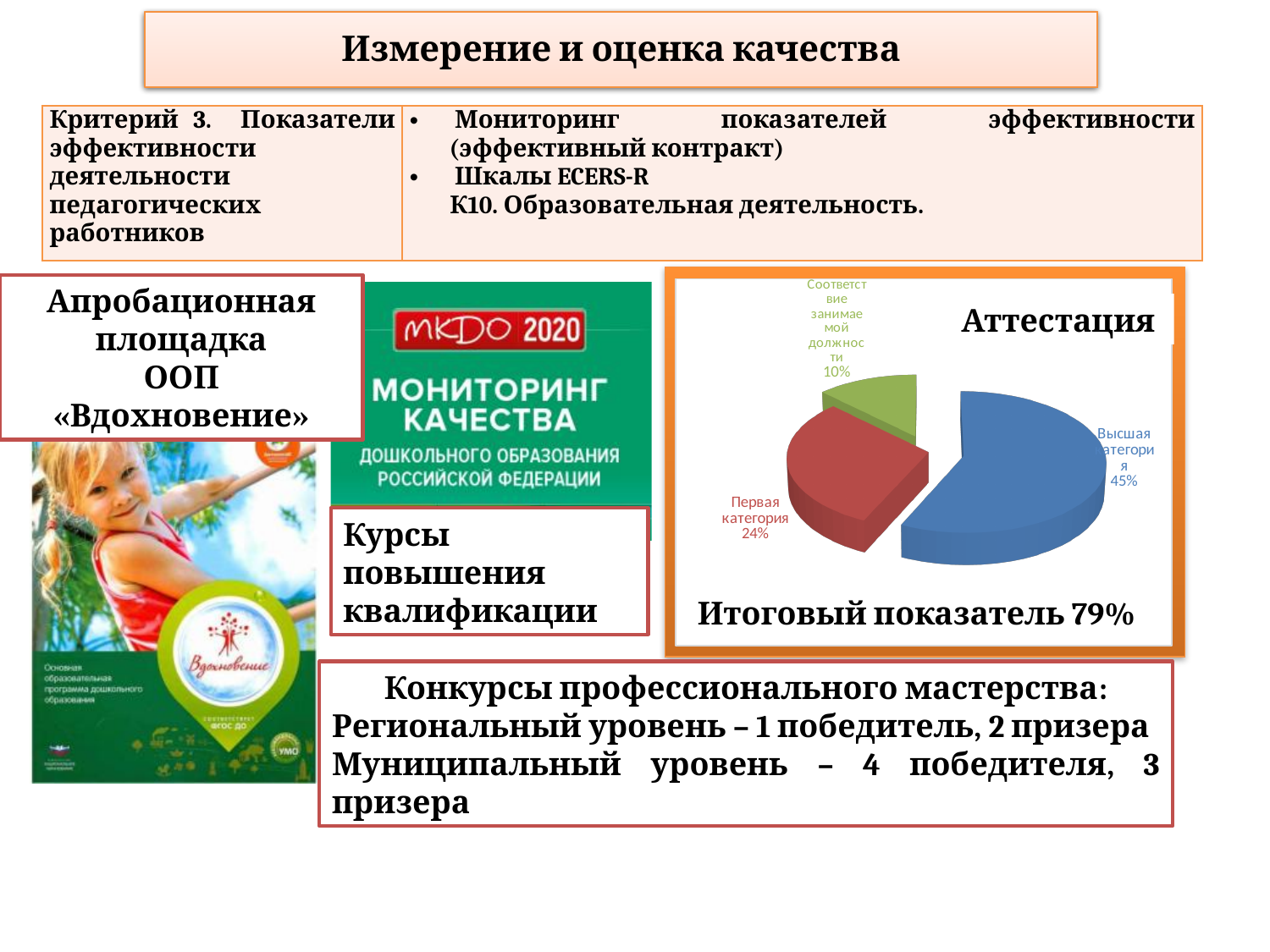
What is the sum of the three percentages labelled on the pie chart? 79% What is the difference in percentage points between "Высшая категория" and "Первая категория"? 21 How many slices does the pie chart have? 3 What percentage is shown for the slice "Высшая категория"? 45% Which slice of the pie chart is the smallest? Соответствие занимаемой должности Which slice of the pie chart is the largest? Высшая категория What kind of chart is shown on the slide? Pie chart What colour is the slice for "Высшая категория"? Blue What percentage is shown for the slice "Соответствие занимаемой должности"? 10% What percentage is shown for the slice "Первая категория"? 24% Which is larger: the slice for "Высшая категория" or the slice for "Первая категория"? Высшая категория What is the title of the pie chart? Аттестация